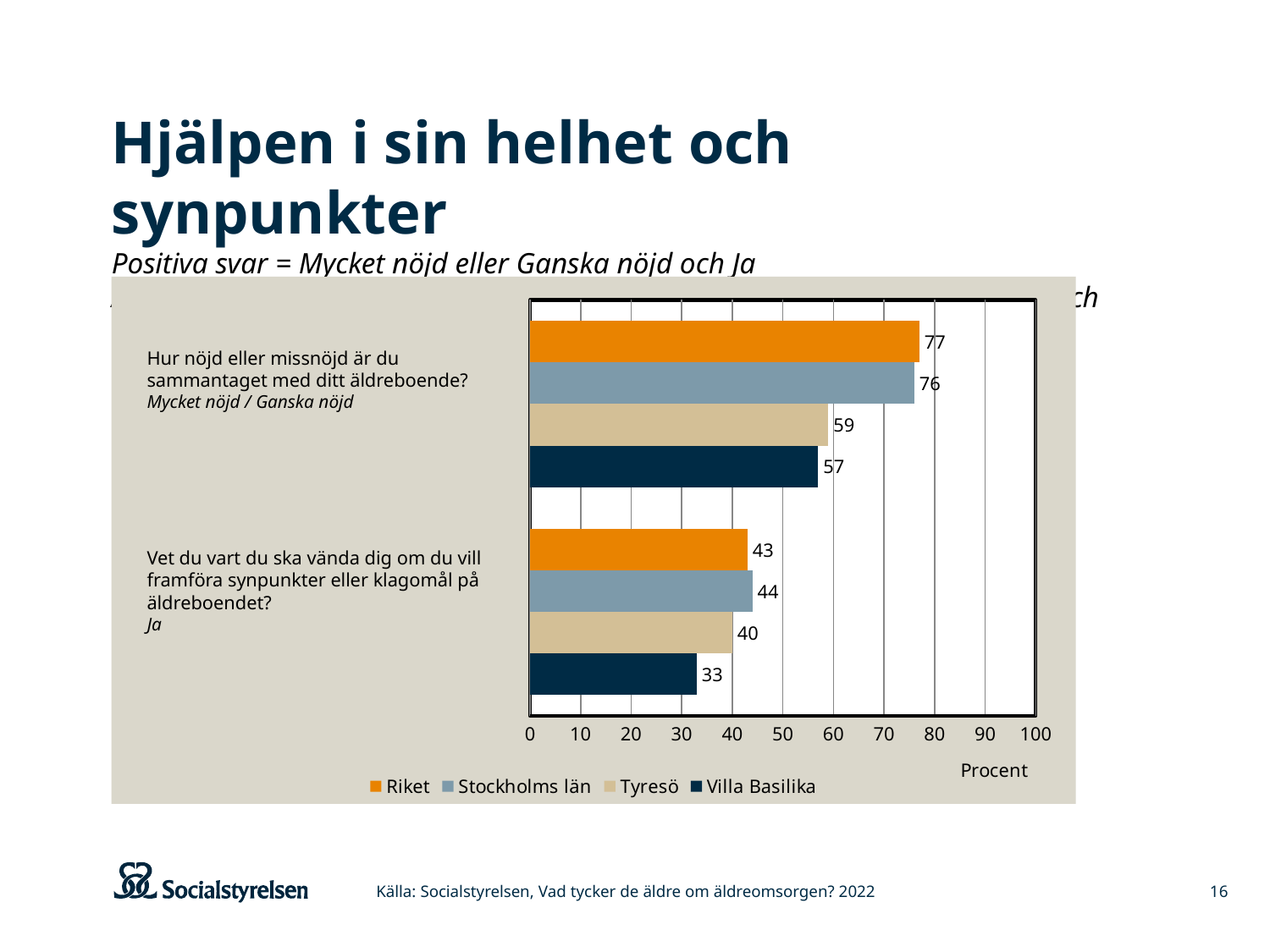
On the question "Hur nöjd eller missnöjd är du sammantaget med ditt äldreboende?", which is larger: the value for Tyresö or the value for Villa Basilika? Tyresö What is the value for Villa Basilika on the question "Hur nöjd eller missnöjd är du sammantaget med ditt äldreboende?"? 57 Which series has the lowest value on the question "Vet du vart du ska vända dig om du vill framföra synpunkter eller klagomål på äldreboendet?"? Villa Basilika What is the value for Riket on the question "Hur nöjd eller missnöjd är du sammantaget med ditt äldreboende?"? 77 What is the value for Tyresö on the question "Vet du vart du ska vända dig om du vill framföra synpunkter eller klagomål på äldreboendet?"? 40 What is the difference between the Stockholms län and Villa Basilika values on the question "Vet du vart du ska vända dig om du vill framföra synpunkter eller klagomål på äldreboendet?"? 11 What kind of chart is shown on the slide? Bar chart How many question categories are shown on the chart? 2 How many series does the legend list? 4 Which series has the highest value on the question "Hur nöjd eller missnöjd är du sammantaget med ditt äldreboende?"? Riket What is the difference between the Riket and Villa Basilika values on the question "Hur nöjd eller missnöjd är du sammantaget med ditt äldreboende?"? 20 What unit label is shown on the x axis of the chart? Procent